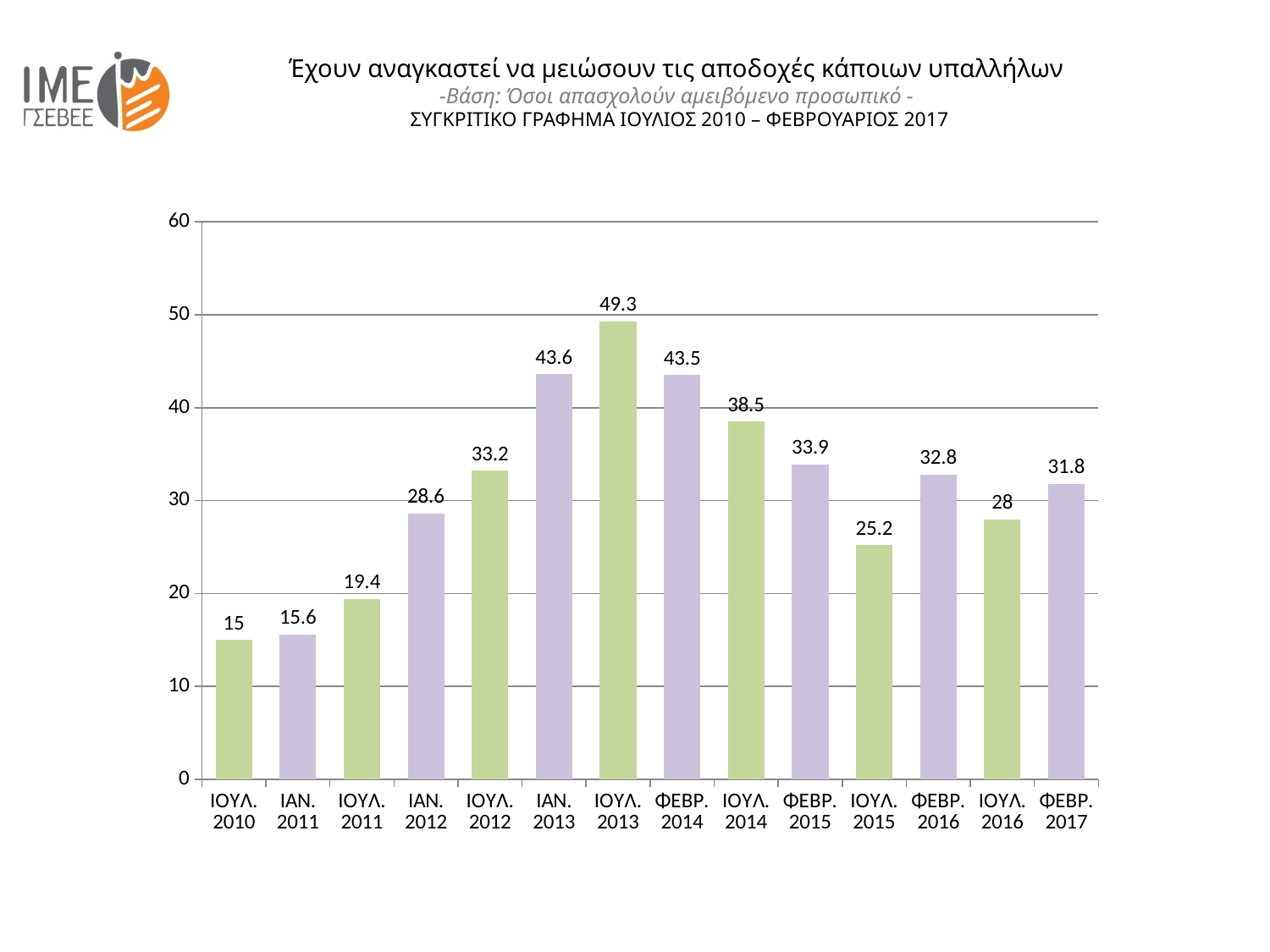
How many periods (bars) are shown on the chart? 14 Do the values rise or fall from ΙΟΥΛ. 2010 to ΙΟΥΛ. 2013? Rise What is the value for ΦΕΒΡ. 2017? 31.8 What is the value for ΙΑΝ. 2012? 28.6 What is the highest value shown on the vertical axis? 60 What is the difference between the values for ΙΟΥΛ. 2015 and ΙΟΥΛ. 2016? 2.8 Which period has the lowest value? ΙΟΥΛ. 2010 What is the value for ΙΟΥΛ. 2013? 49.3 What is the difference between the values for ΙΟΥΛ. 2013 and ΦΕΒΡ. 2017? 17.5 What kind of chart is shown on the slide? Bar chart Which is larger, the value for ΦΕΒΡ. 2015 or the value for ΦΕΒΡ. 2016? ΦΕΒΡ. 2015 Which period has the highest value? ΙΟΥΛ. 2013